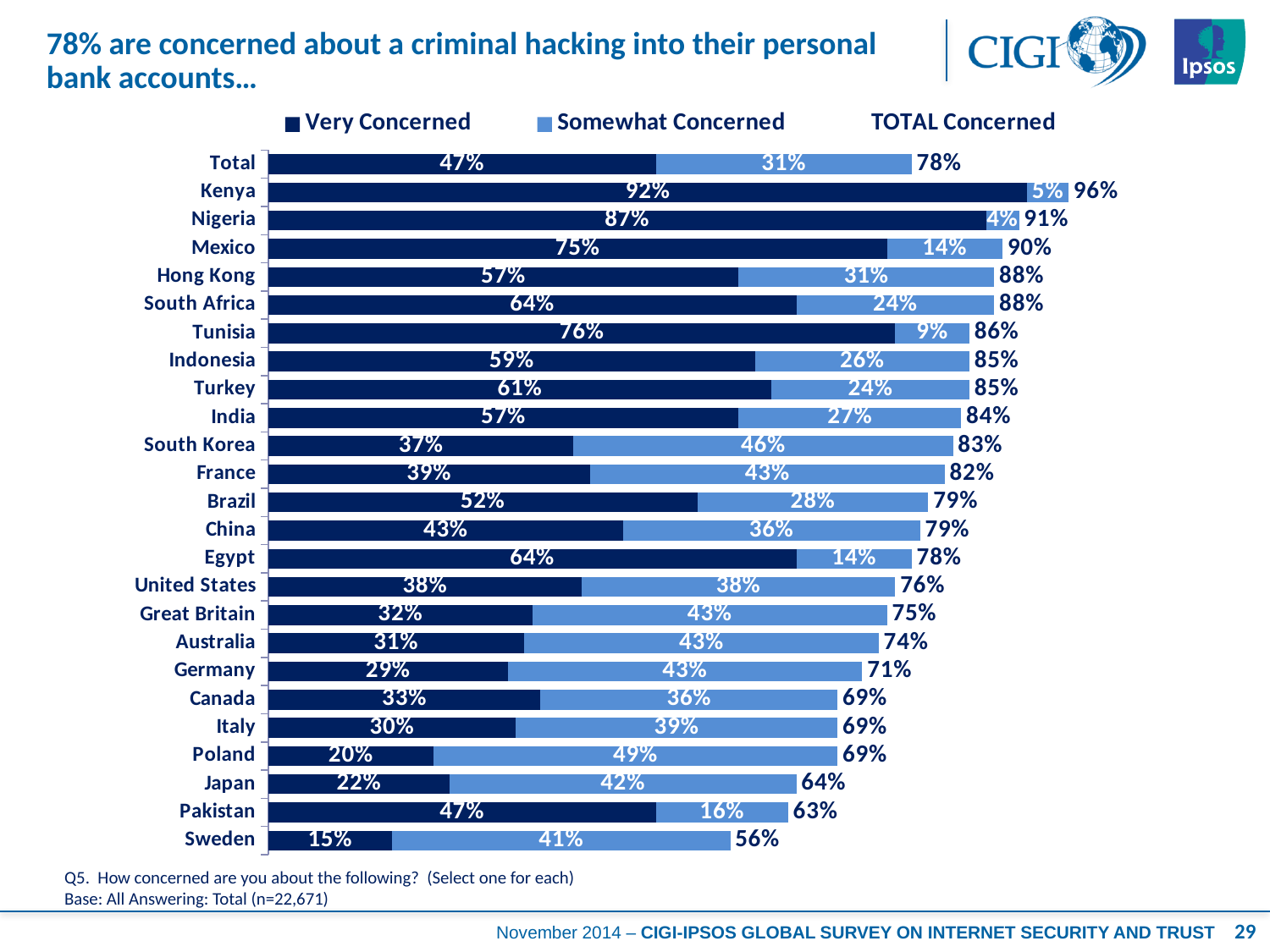
How many series does the legend list with a colour swatch? 2 What percentage of respondents in Kenya are Very Concerned? 92% Which has a larger Somewhat Concerned value, Poland or Japan? Poland What is the Somewhat Concerned value for South Korea? 46% What is the total of the stacked bar for Germany? 71% What is the difference between the Very Concerned values for Nigeria and Mexico? 12% Which country has the lowest Very Concerned value? Sweden How many categories (rows) are shown in the chart? 25 What is the TOTAL Concerned value for Sweden? 56% Which series is shown in dark blue in the legend? Very Concerned Which country has the highest TOTAL Concerned value? Kenya What kind of chart is shown on the slide? Stacked bar chart